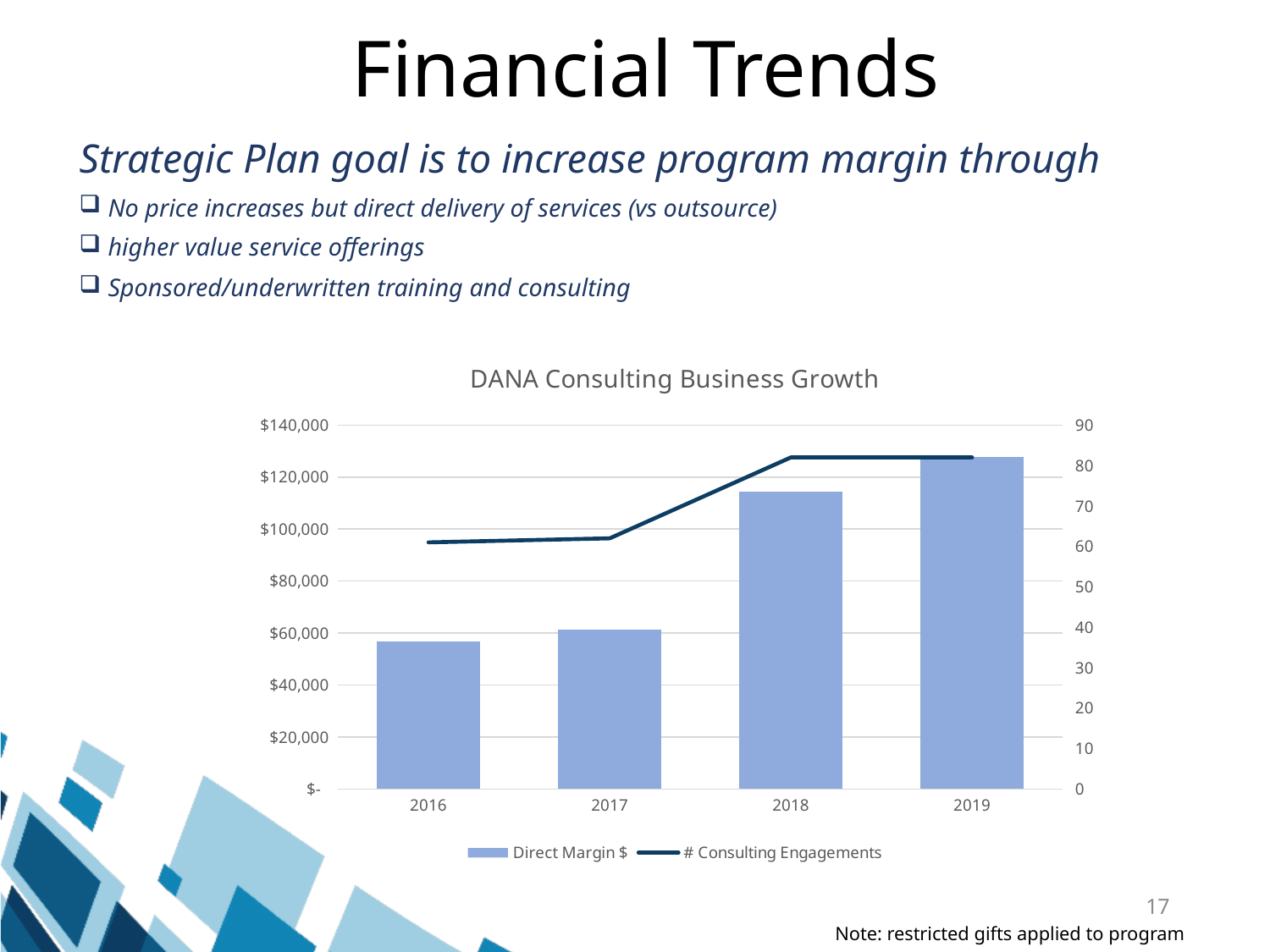
What is the title of the chart? DANA Consulting Business Growth Is the Direct Margin $ for 2019 greater or less than $120,000? greater Is the Direct Margin $ for 2016 greater or less than $60,000? less Which year has the lowest Direct Margin $? 2016 Is the Direct Margin $ for 2018 greater or less than $100,000? greater How many series does the chart legend list? 2 Which year has a larger Direct Margin $, 2017 or 2018? 2018 Does the Direct Margin $ rise or fall from 2016 to 2019? rise What type of chart is shown on the slide? A combination bar and line chart Which year has the highest Direct Margin $? 2019 How many years are shown on the x axis of the chart? 4